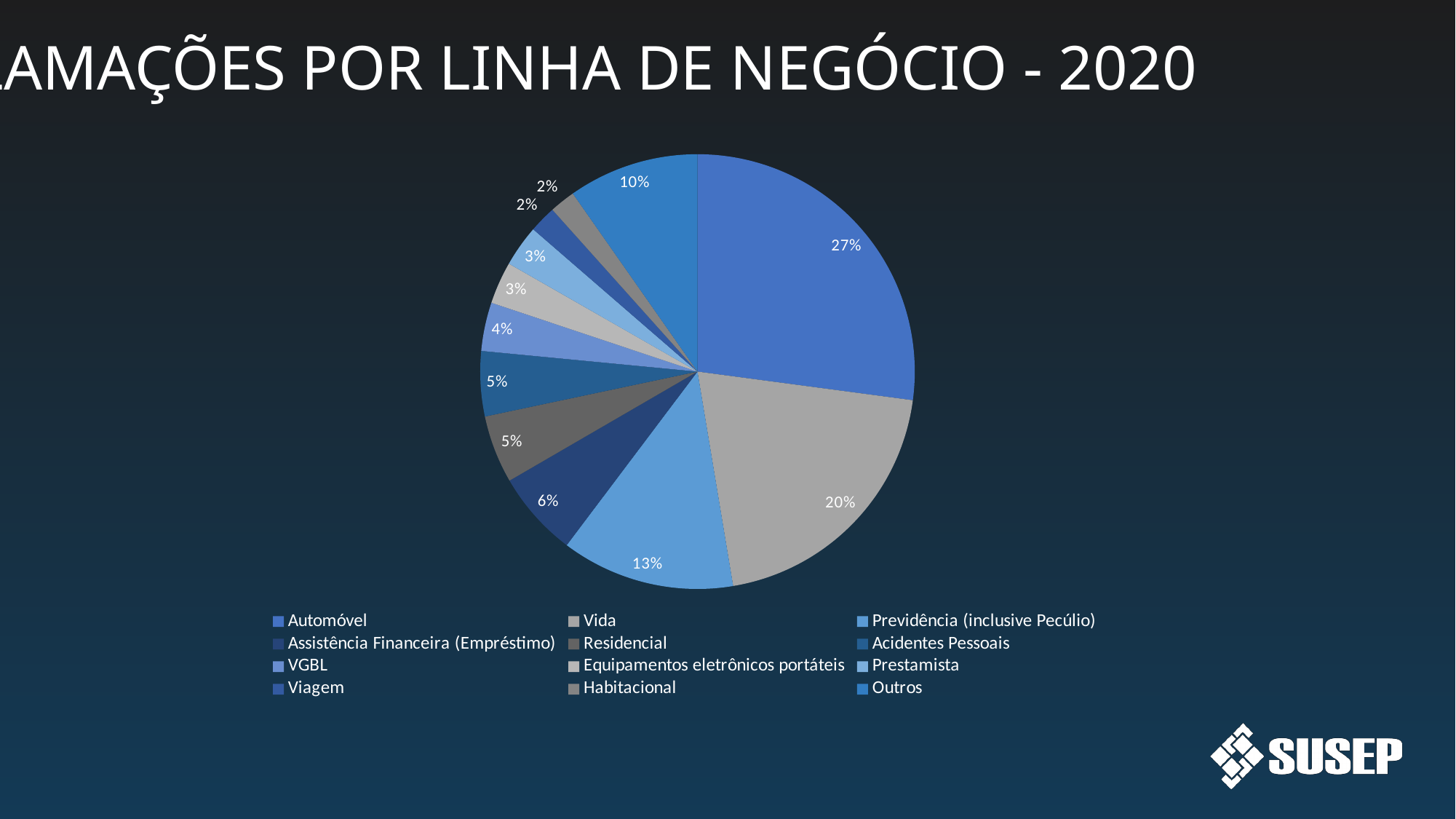
What is the value shown for Vida? 20% What is the value shown for Assistência Financeira (Empréstimo)? 6% What is the combined share of Automóvel and Vida? 47% What share of the pie does Automóvel represent? 27% Which year does the chart title refer to? 2020 What type of chart is shown on the slide? pie chart What is the value shown for Previdência (inclusive Pecúlio)? 13% Which is larger, the slice for Vida or the slice for Previdência (inclusive Pecúlio)? Vida What is the difference in percentage points between Automóvel and Vida? 7 How many categories does the legend of the pie chart list? 12 Which category has the largest slice of the pie? Automóvel What is the value shown for Outros? 10%